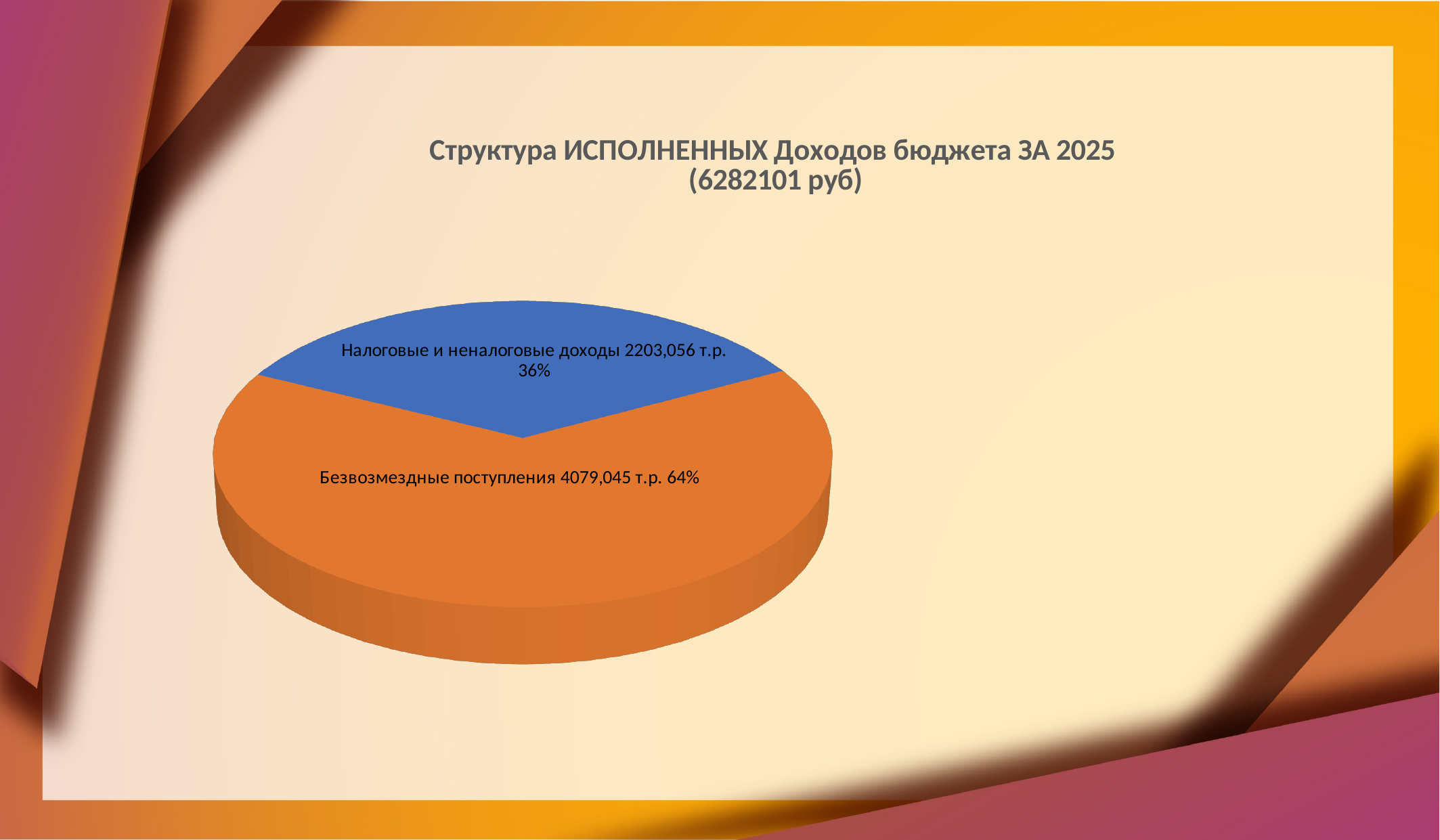
Which category has the largest slice? Безвозмездные поступления Which category has the smallest slice? Налоговые и неналоговые доходы How many slices does the pie chart have? 2 What kind of chart is shown on the slide? Pie chart What is the value for Безвозмездные поступления? 4079,045 т.р. What share of the pie does Безвозмездные поступления represent? 64% What colour is the slice for Налоговые и неналоговые доходы? Blue What is the difference in percentage share between Безвозмездные поступления and Налоговые и неналоговые доходы? 28% What is the title of the chart? Структура ИСПОЛНЕННЫХ Доходов бюджета ЗА 2025 (6282101 руб) What share of the pie does Налоговые и неналоговые доходы represent? 36% Which is larger: Безвозмездные поступления or Налоговые и неналоговые доходы? Безвозмездные поступления What is the value for Налоговые и неналоговые доходы? 2203,056 т.р.